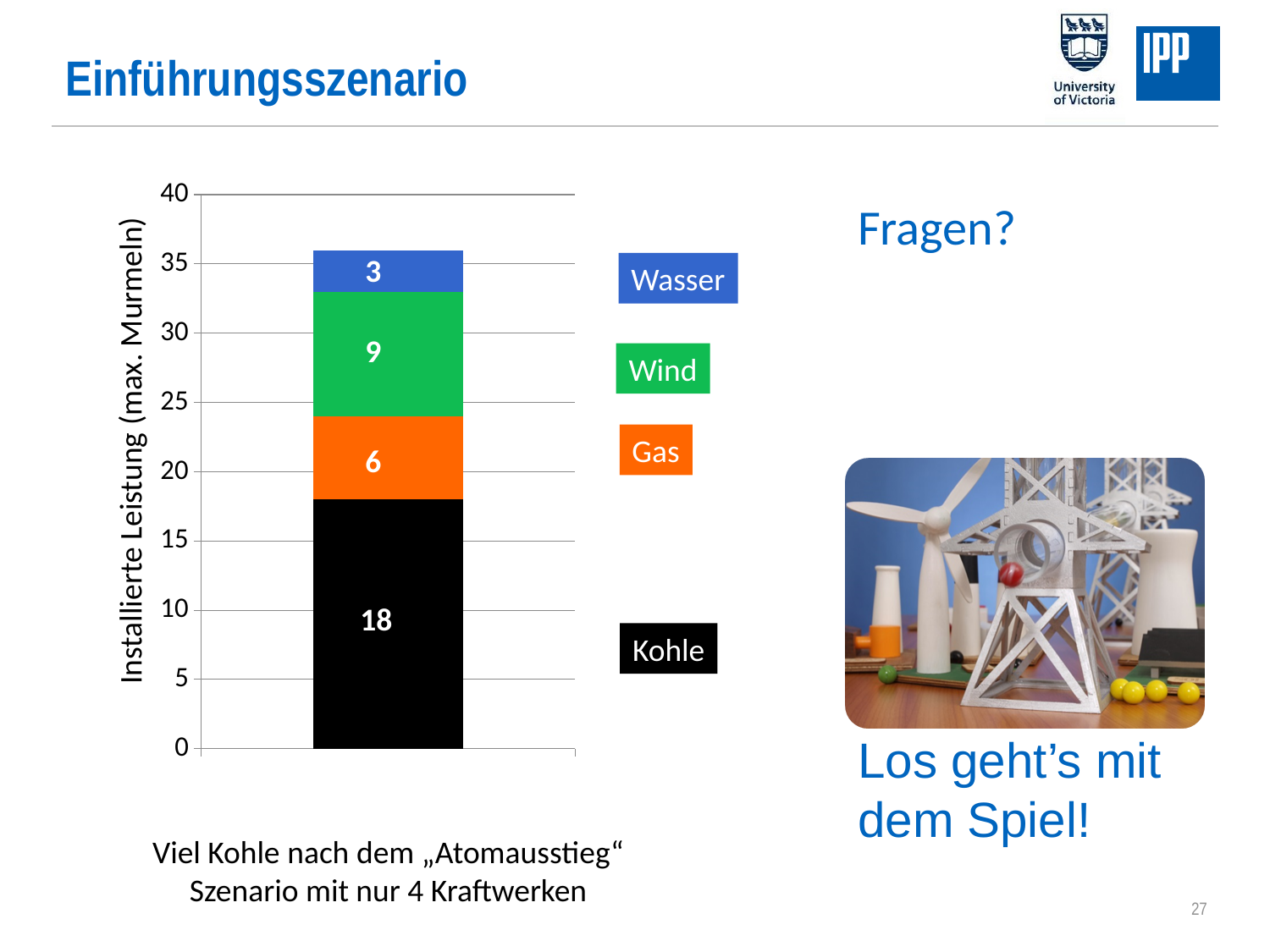
What is the difference between the Kohle value and the Wind value? 9 What value is shown for Wind in the stacked bar? 9 What is the label of the vertical axis? Installierte Leistung (max. Murmeln) What value is shown for Wasser in the stacked bar? 3 How many energy sources are listed in the legend? 4 What kind of chart is shown on the slide? Stacked bar chart What value is shown for Kohle in the stacked bar? 18 What is the total of the stacked bar? 36 Which is larger, the value for Gas or the value for Wind? Wind Which energy source has the smallest segment in the stacked bar? Wasser What value is shown for Gas in the stacked bar? 6 Which energy source has the largest segment in the stacked bar? Kohle